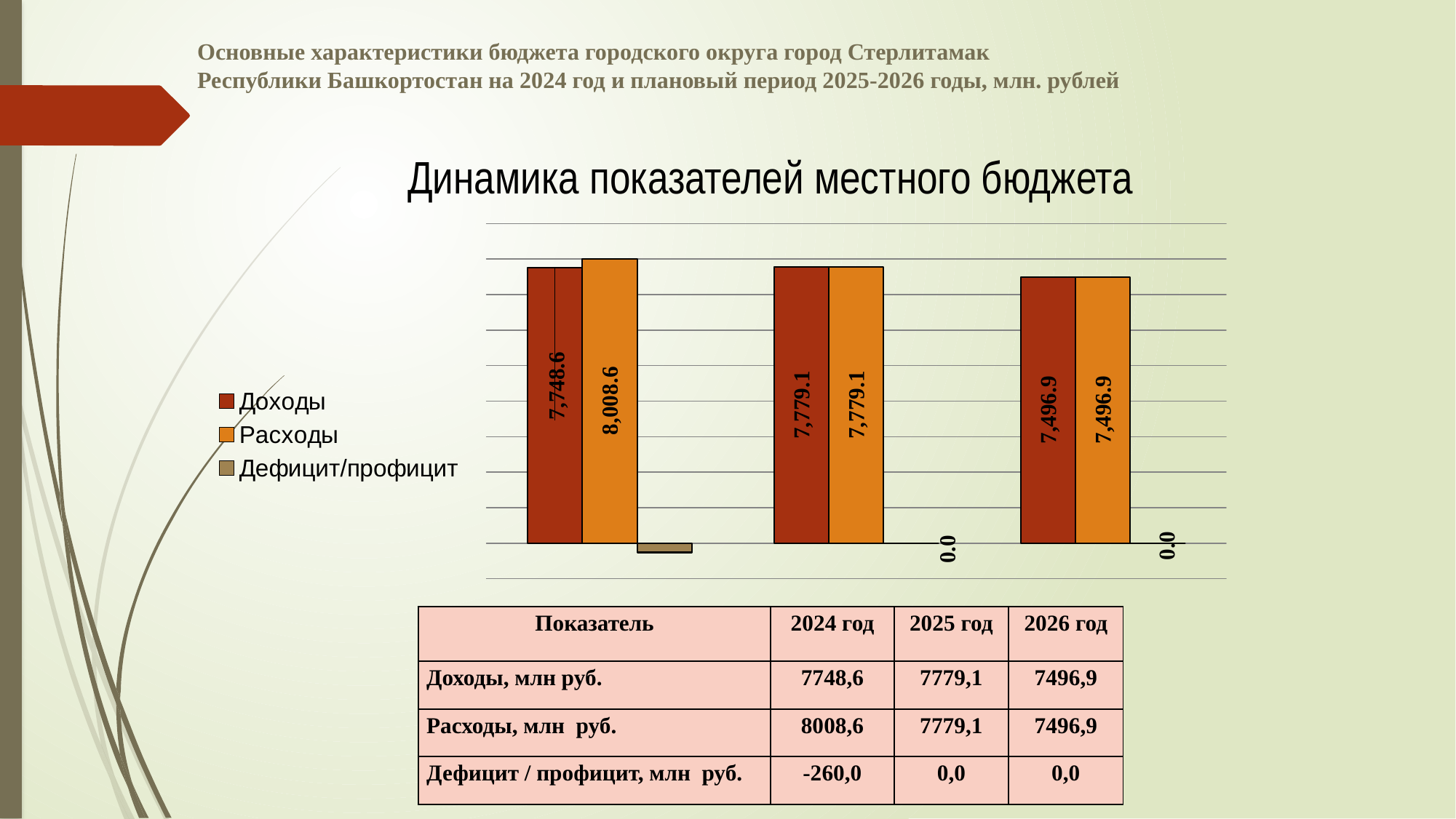
Which series in the legend is shown in the brownish-grey colour? Дефицит/профицит Which group of bars has the highest Расходы value in the chart? the first (leftmost) group, 8,008.6 What is the data label on the Доходы bar in the second (middle) group of the chart? 7,779.1 What is the data label on the Доходы bar in the first (leftmost) group of the chart? 7,748.6 What is the data label on the Расходы bar in the third (rightmost) group of the chart? 7,496.9 What kind of chart is shown under the title "Динамика показателей местного бюджета"? bar chart In the first (leftmost) group of the chart, what is the difference between the Расходы bar (8,008.6) and the Доходы bar (7,748.6)? 260.0 In the first (leftmost) group of the chart, which is larger: Доходы or Расходы? Расходы How many groups of bars are plotted in the chart? 3 What is the data label for Дефицит/профицит in the third (rightmost) group of the chart? 0.0 What is the data label on the Расходы bar in the first (leftmost) group of the chart? 8,008.6 How many series does the legend of the chart list? 3